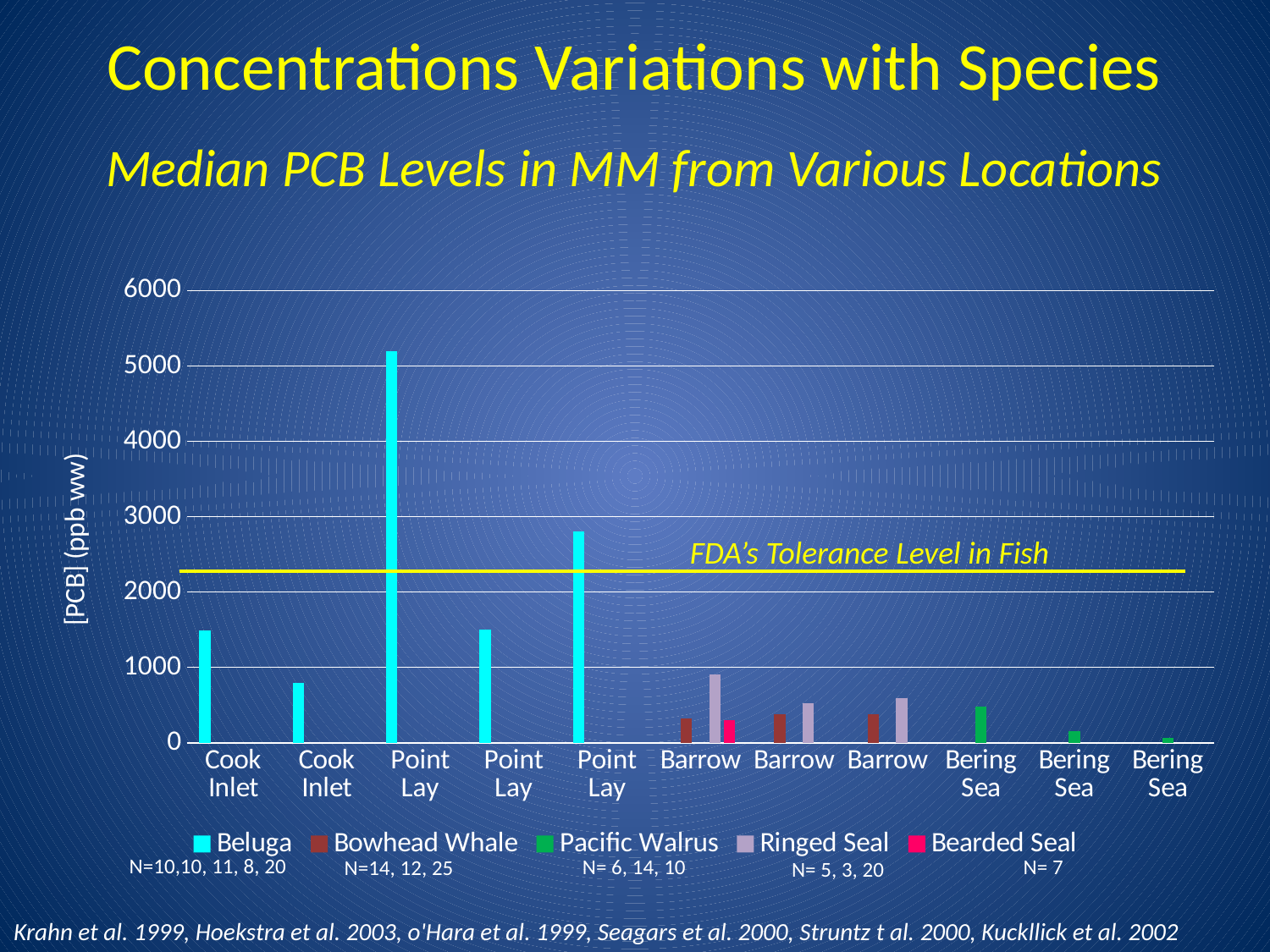
How many series does the legend list? 5 Which series has the tallest bar in the chart? Beluga Is the Beluga bar at the third Point Lay category greater or less than 3000? less What is the label on the y axis of the chart? [PCB] (ppb ww) What type of chart is shown on the slide? bar chart What is the title of the chart? Median PCB Levels in MM from Various Locations How many category labels are shown along the x axis? 11 Is the Beluga bar at the first Cook Inlet category greater or less than 1000? greater Is the Beluga bar at the second Cook Inlet category greater or less than 1000? less Which is larger: the Beluga bar at the first Cook Inlet category or the Beluga bar at the second Cook Inlet category? first Cook Inlet